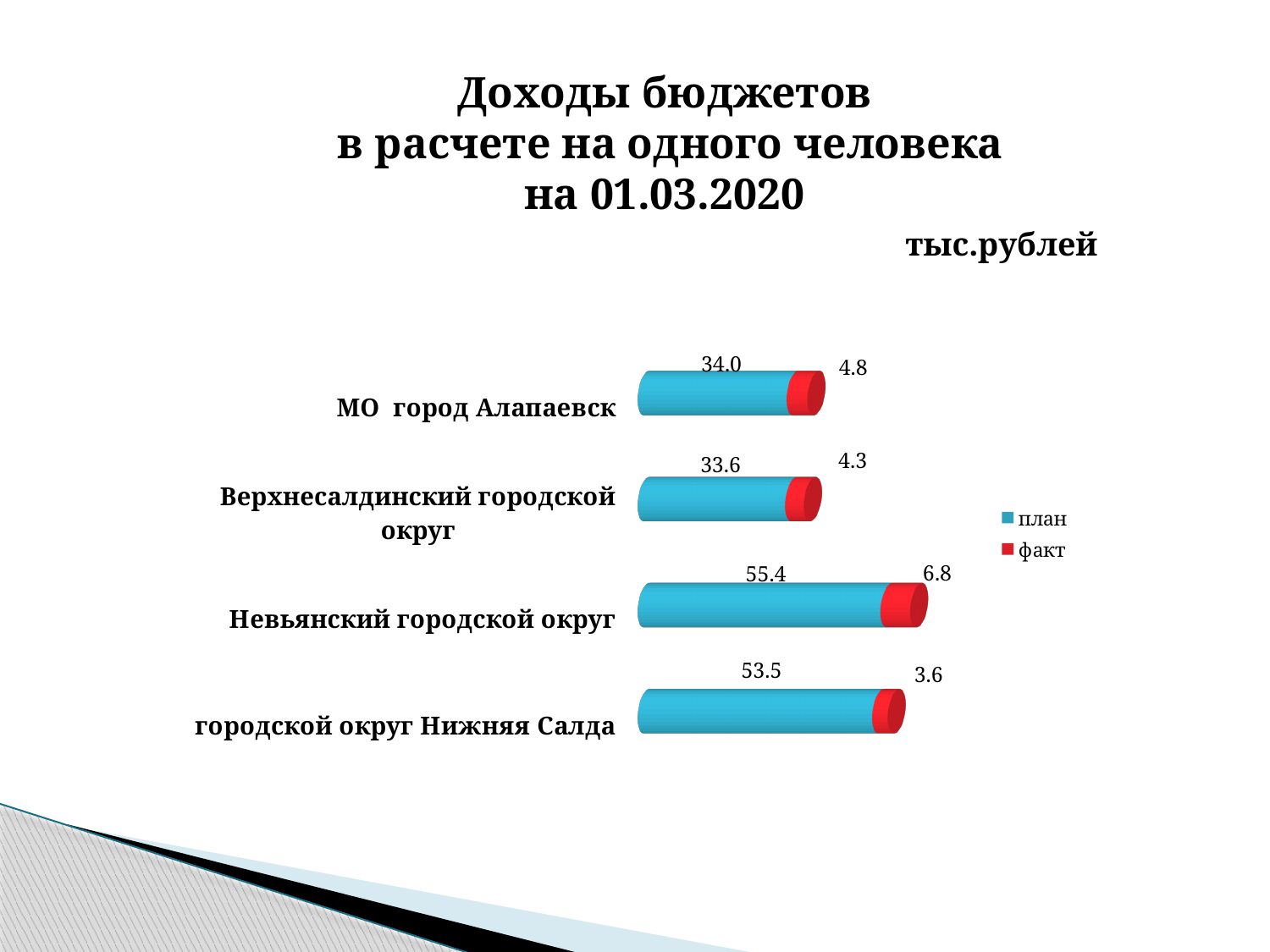
What is the план value for городской округ Нижняя Салда? 53.5 What is the план value for Невьянский городской округ? 55.4 What is the difference between the план values for Невьянский городской округ and МО город Алапаевск? 21.4 What kind of chart is shown on the slide? bar chart How many series does the legend list? 2 Which category has the lowest факт value? городской округ Нижняя Салда What is the факт value for Верхнесалдинский городской округ? 4.3 Which category has the highest план value? Невьянский городской округ What is the факт value for МО город Алапаевск? 4.8 What is the total of the stacked bar for Невьянский городской округ (план plus факт)? 62.2 Which is larger, the факт value for Невьянский городской округ or the факт value for городской округ Нижняя Салда? Невьянский городской округ How many categories are shown in the chart? 4